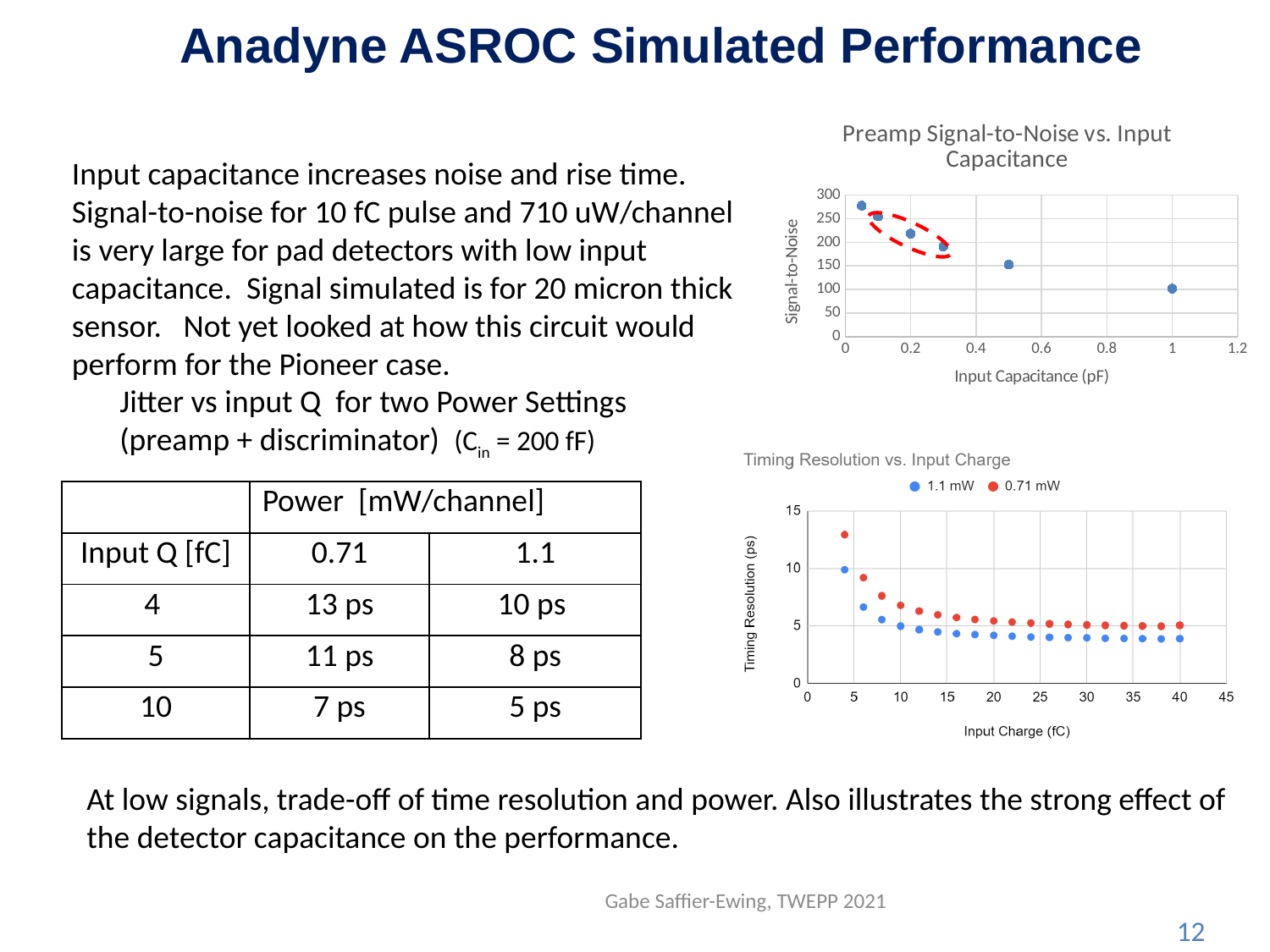
What is the x-axis title of the "Preamp Signal-to-Noise vs. Input Capacitance" chart? Input Capacitance (pF) What kind of chart is the "Preamp Signal-to-Noise vs. Input Capacitance" chart? scatter chart How many data points are plotted in the "Preamp Signal-to-Noise vs. Input Capacitance" chart? 6 In the "Preamp Signal-to-Noise vs. Input Capacitance" chart, is the signal-to-noise of the leftmost point greater or less than 250? greater How many series does the legend of the "Timing Resolution vs. Input Charge" chart list? 2 In the "Preamp Signal-to-Noise vs. Input Capacitance" chart, is the signal-to-noise at 0.5 pF greater or less than 200? less In the "Preamp Signal-to-Noise vs. Input Capacitance" chart, does signal-to-noise rise or fall as input capacitance increases? fall What are the two series named in the legend of the "Timing Resolution vs. Input Charge" chart? 1.1 mW and 0.71 mW In the "Timing Resolution vs. Input Charge" chart, does timing resolution rise or fall as input charge increases? fall In the "Timing Resolution vs. Input Charge" chart, which series has the higher timing resolution at low input charge, 1.1 mW or 0.71 mW? 0.71 mW In the "Preamp Signal-to-Noise vs. Input Capacitance" chart, is the signal-to-noise at 1 pF greater or less than 150? less